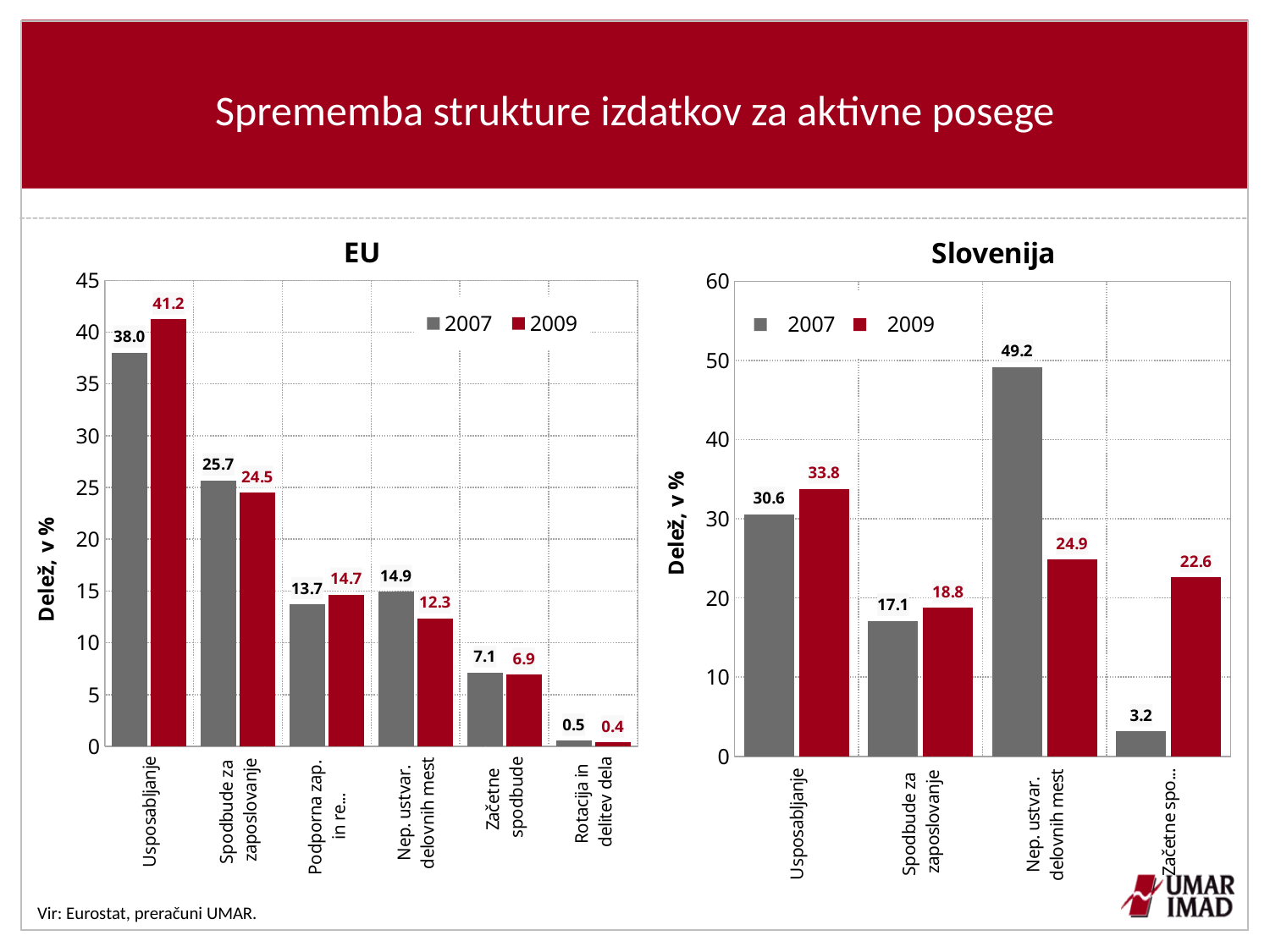
In the EU chart, what is the difference between the 2007 and 2009 values for Spodbude za zaposlovanje? 1.2 What is the y-axis label of the Slovenija chart? Delež, v % What type of chart is the EU chart? bar chart In the EU chart, which category has the lowest 2009 value? Rotacija in delitev dela In the EU chart, what is the 2009 value for Usposabljanje? 41.2 In the Slovenija chart, what is the difference between the 2007 and 2009 values for Nep. ustvar. delovnih mest? 24.3 In the Slovenija chart, what is the 2007 value for Nep. ustvar. delovnih mest? 49.2 How many categories are shown in the EU chart? 6 How many series does the legend of the Slovenija chart list? 2 In the Slovenija chart, is the 2009 value for Usposabljanje greater or less than 30? greater In the Slovenija chart, which category has the highest 2009 value? Usposabljanje In the EU chart, which is larger for Nep. ustvar. delovnih mest: the 2007 value or the 2009 value? 2007